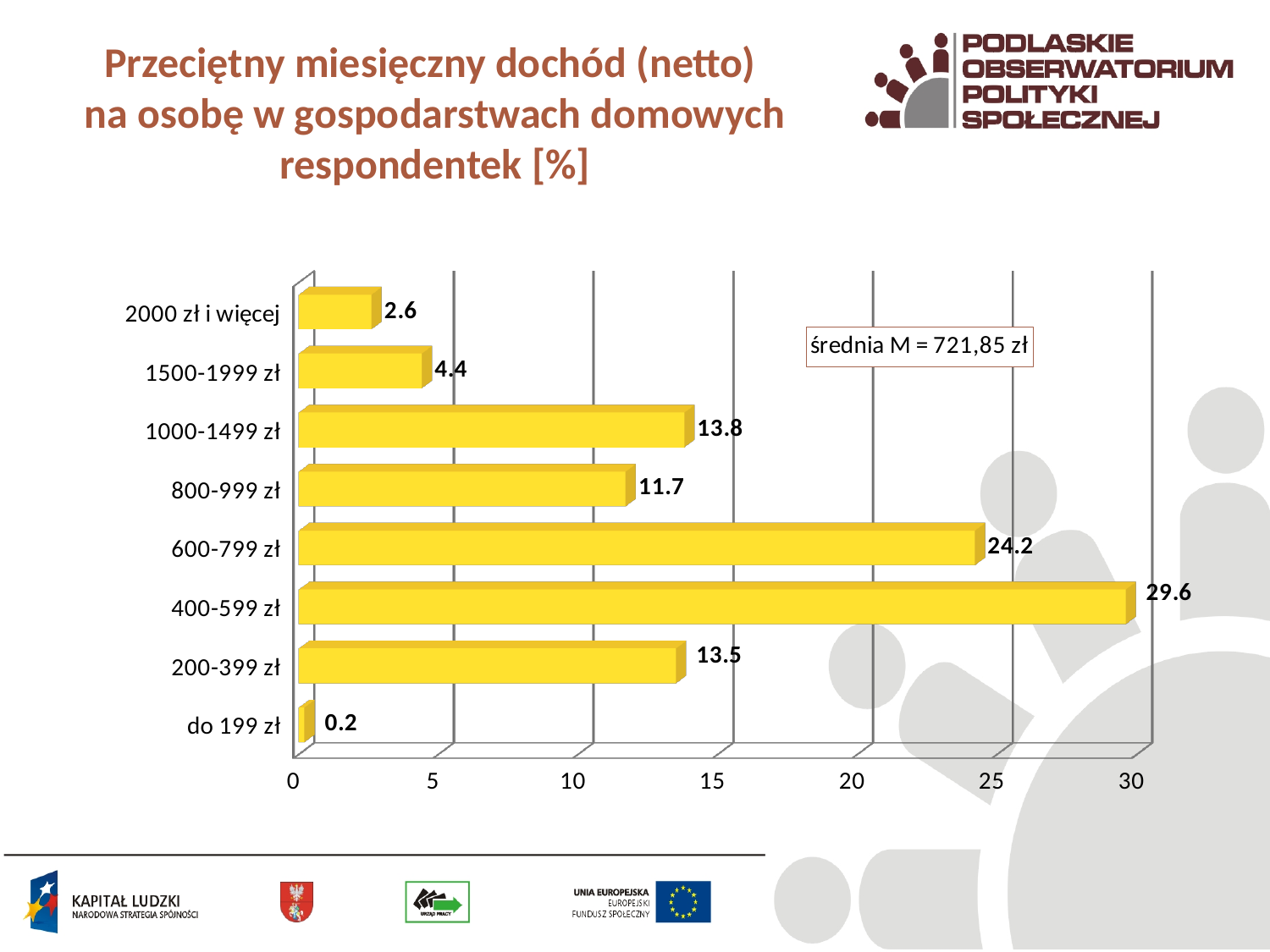
Which category has the highest value? 400-599 zł Which category has the lowest value? do 199 zł What is the value for the 400-599 zł category? 29.6 What is the difference between the values for 400-599 zł and 600-799 zł? 5.4 What is the mean value (średnia M) stated in the text box on the chart? 721,85 zł What is the difference between the values for 1500-1999 zł and 2000 zł i więcej? 1.8 What kind of chart is shown on the slide? bar chart What is the value for the 2000 zł i więcej category? 2.6 What is the value for the 1000-1499 zł category? 13.8 Is the value for 600-799 zł greater or less than 20? greater How many income categories are shown on the chart? 8 Which is larger, the value for 800-999 zł or the value for 200-399 zł? 200-399 zł